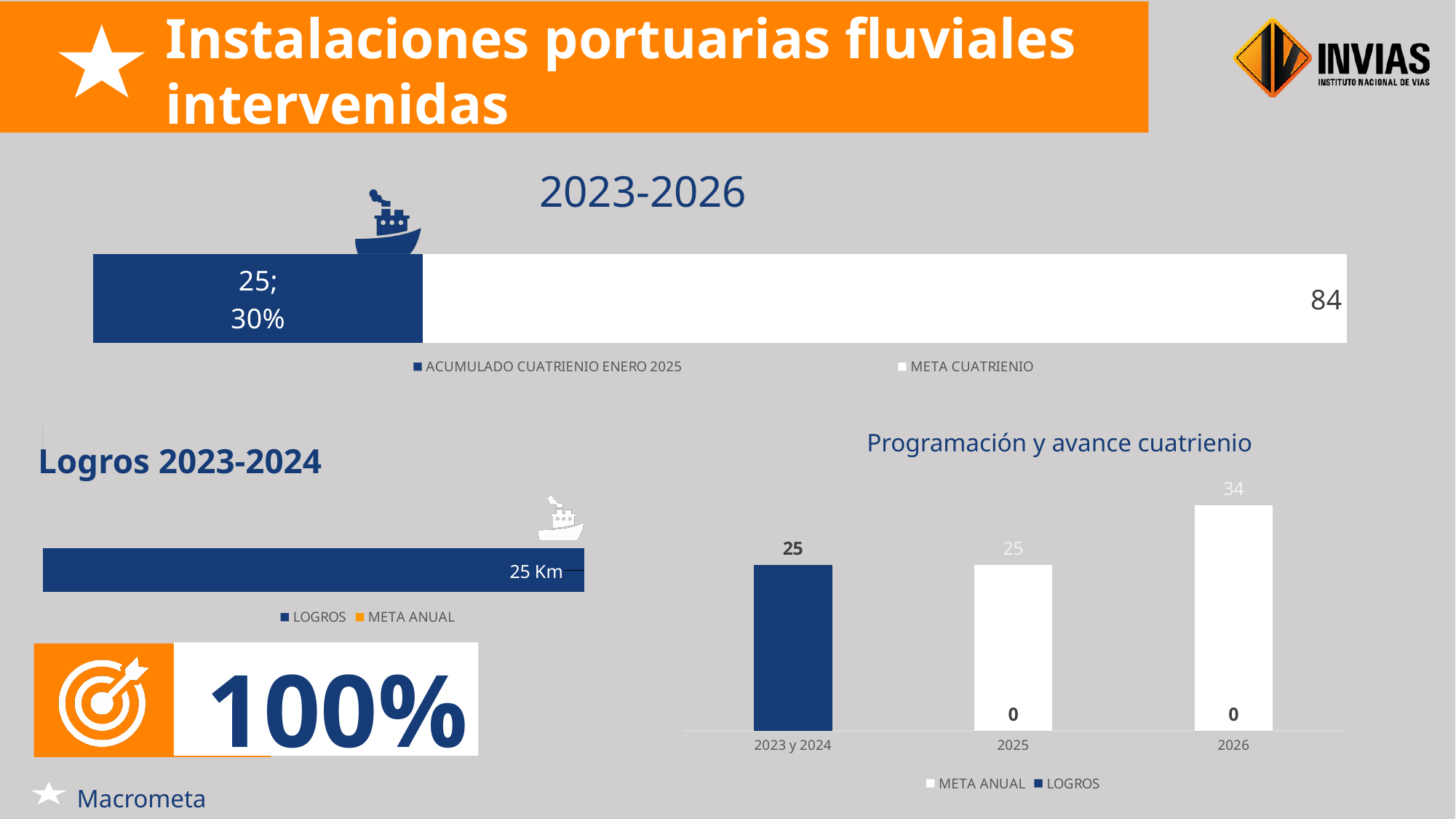
In the '2023-2026' chart, how many series does the legend list? 2 In the 'Logros 2023-2024' chart, what kind of chart is it? Bar chart In the '2023-2026' chart, what is the value for META CUATRIENIO? 84 In the 'Programación y avance cuatrienio' chart, what is the LOGROS value for 2023 y 2024? 25 In the 'Programación y avance cuatrienio' chart, what is the META ANUAL value for 2026? 34 In the '2023-2026' chart, what is the difference between META CUATRIENIO (84) and ACUMULADO CUATRIENIO ENERO 2025 (25)? 59 In the 'Logros 2023-2024' chart, what value is shown on the LOGROS bar? 25 Km In the 'Programación y avance cuatrienio' chart, what is the LOGROS value for 2025? 0 In the 'Programación y avance cuatrienio' chart, which year has the highest META ANUAL value? 2026 In the 'Programación y avance cuatrienio' chart, how many categories are on the x axis? 3 In the '2023-2026' chart, what label is shown on the ACUMULADO CUATRIENIO ENERO 2025 bar? 25; 30% In the '2023-2026' chart, which is larger, ACUMULADO CUATRIENIO ENERO 2025 or META CUATRIENIO? META CUATRIENIO